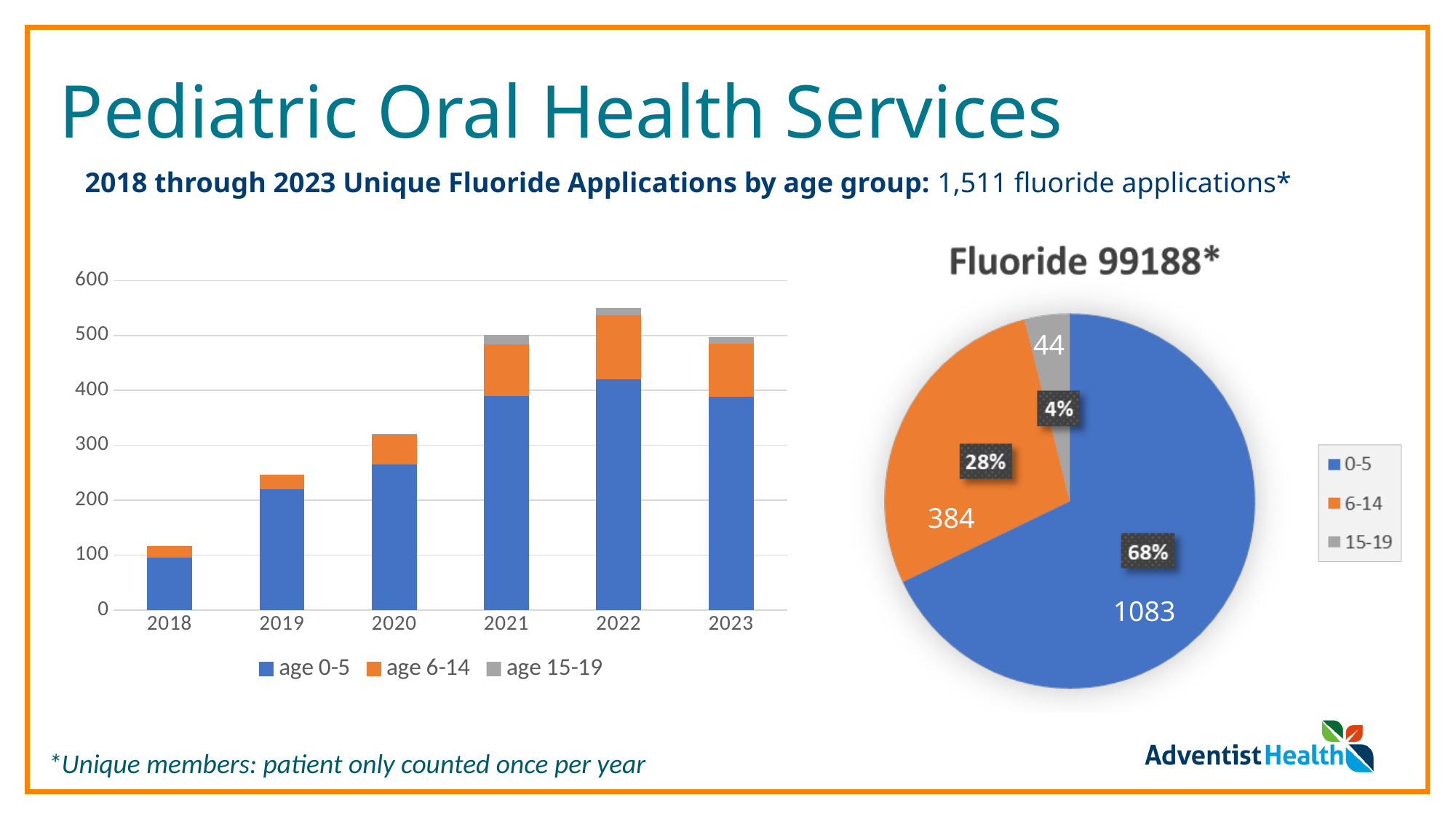
In the bar chart on the left, is the total height of the 2018 bar greater or less than 200? less What kind of chart is the 'Fluoride 99188*' chart? pie chart In the bar chart on the left, how many series does the legend list? 3 In the 'Fluoride 99188*' pie chart, what share of the pie does the 6-14 age group have? 28% In the bar chart on the left, how many years are shown on the x axis? 6 In the bar chart on the left, is the total height of the 2022 bar greater or less than 500? greater In the 'Fluoride 99188*' pie chart, what is the value for the 0-5 age group? 1083 In the 'Fluoride 99188*' pie chart, what is the difference between the 0-5 value and the 6-14 value? 699 What kind of chart is the chart on the left of the slide? stacked bar chart In the bar chart on the left, which year has the tallest stacked bar? 2022 In the bar chart on the left, do the stacked bar totals generally rise or fall from 2018 to 2021? rise In the bar chart on the left, which year has the shortest stacked bar? 2018